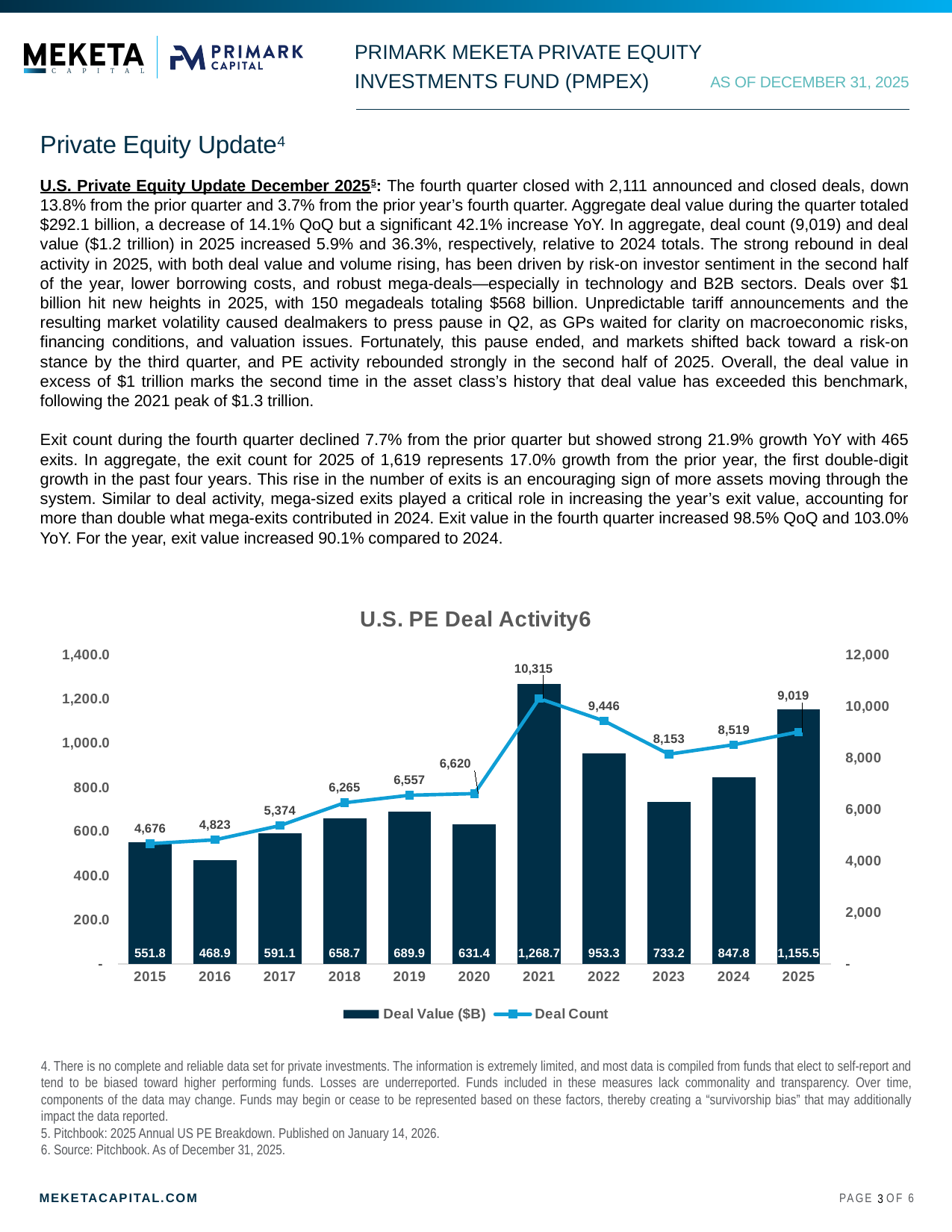
What is the title of the chart? U.S. PE Deal Activity6 What is the difference in Deal Count between 2021 and 2022? 869 Which year has the lowest Deal Value ($B)? 2016 What is the difference in Deal Value ($B) between 2025 and 2024? 307.7 Which year has the highest Deal Count? 2021 What is the Deal Value ($B) for 2016? 468.9 What is the Deal Count for 2025? 9,019 What is the Deal Value ($B) for 2021? 1,268.7 How does the Deal Count change from 2015 to 2021? It rises Which year has the larger Deal Value ($B), 2022 or 2023? 2022 How many years are shown on the x axis of the chart? 11 How many series does the chart legend list? 2